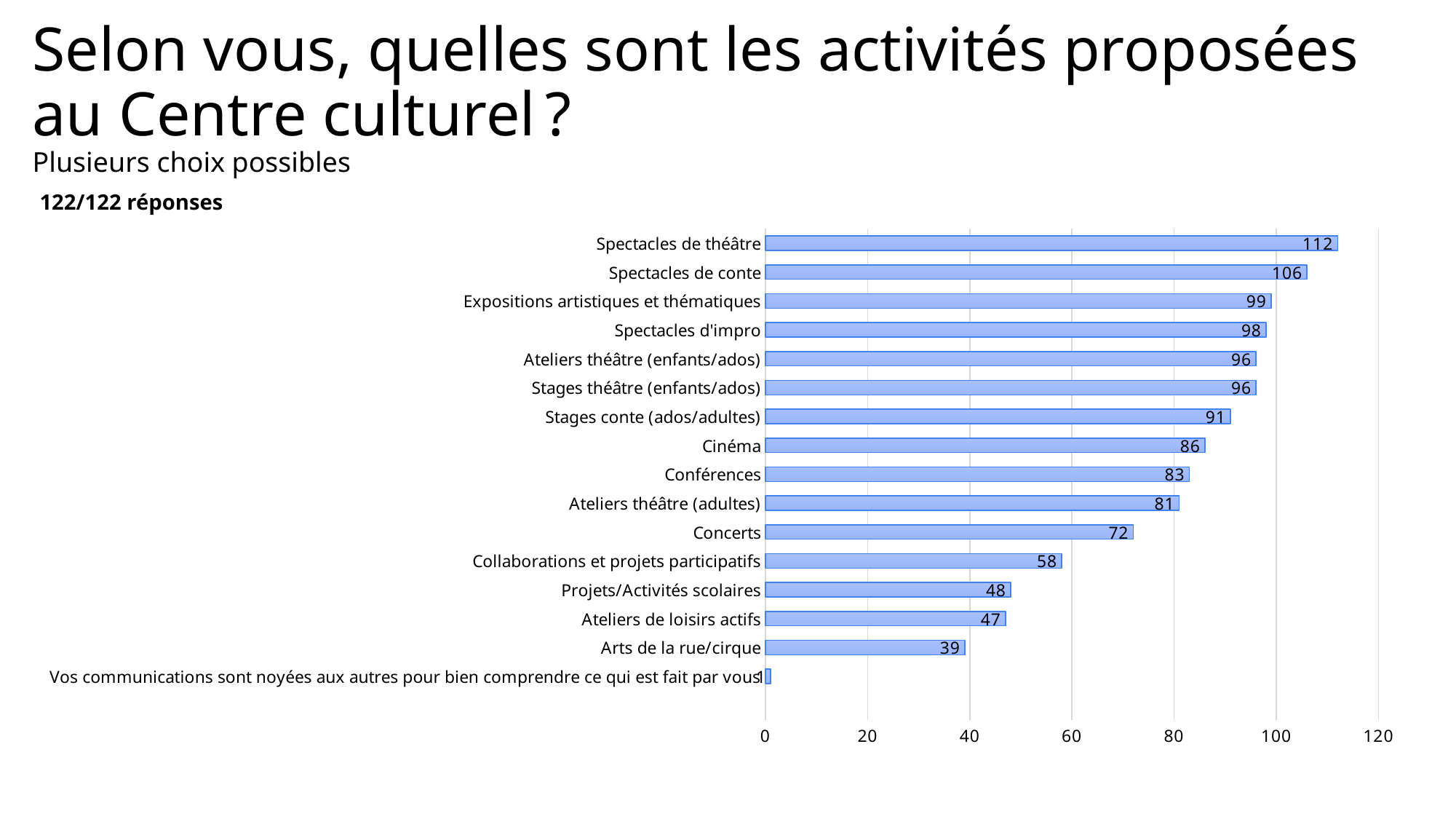
What kind of chart is shown on the slide? Bar chart What is the difference between the values for Spectacles de théâtre and Spectacles de conte? 6 Which category has the highest value? Spectacles de théâtre What value is shown for Cinéma? 86 How many categories are shown in the chart? 16 What value is shown for Arts de la rue/cirque? 39 What is the difference between the values for Concerts and Collaborations et projets participatifs? 14 Which is larger, the value for Conférences or the value for Ateliers théâtre (adultes)? Conférences How many responses does the slide report for this question? 122/122 réponses What value is shown for Spectacles de théâtre? 112 Which category has the lowest value? Vos communications sont noyées aux autres pour bien comprendre ce qui est fait par vous Is the value for Stages conte (ados/adultes) greater or less than 80? greater